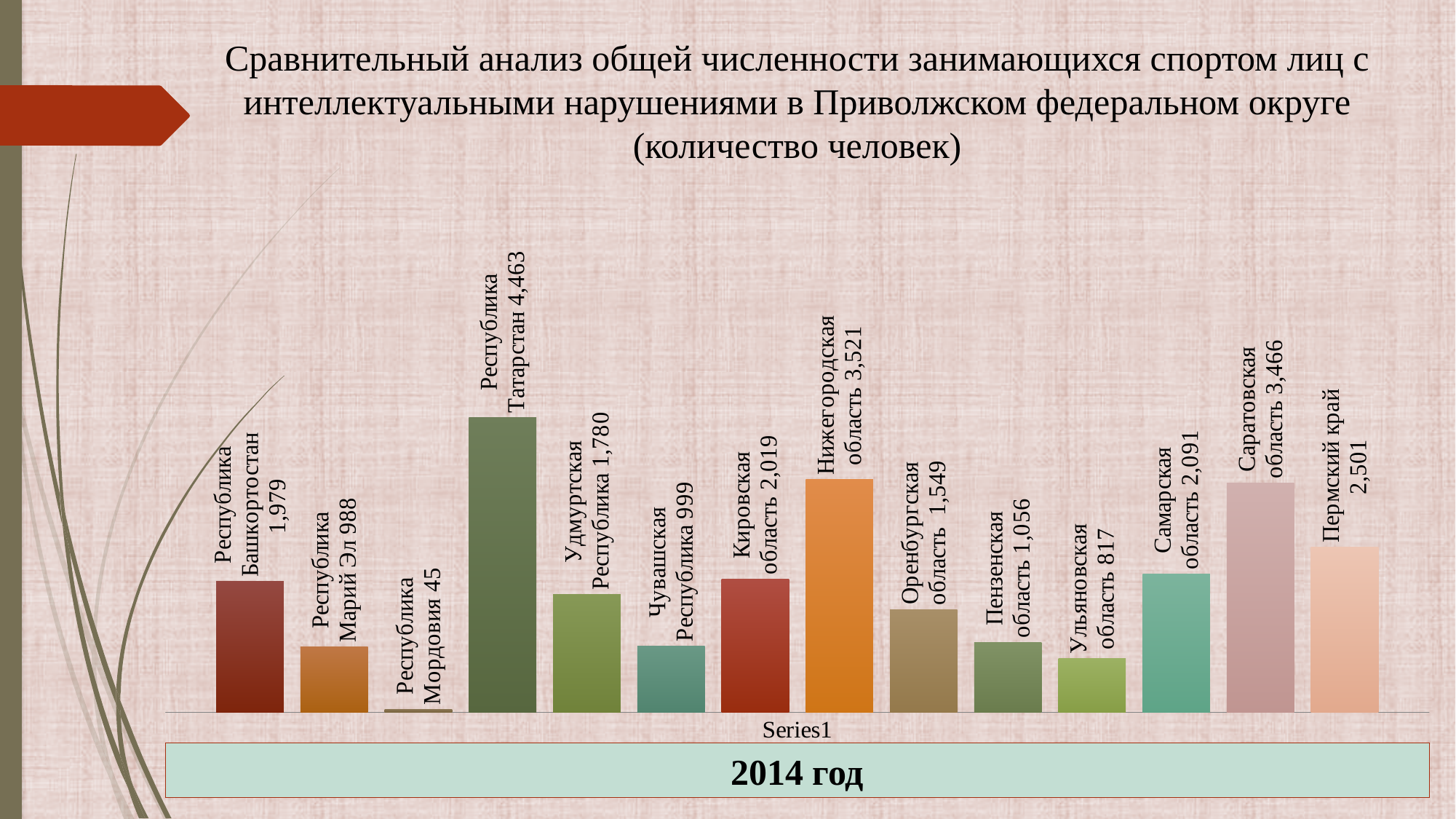
What is the value for Пермский край? 2,501 What is the difference between the values for Республика Татарстан and Саратовская область? 997 Which region has the lowest value? Республика Мордовия What kind of chart is shown on the slide? Bar chart Which region has the highest value? Республика Татарстан What is the value for Ульяновская область? 817 Which is larger, the value for Самарская область or the value for Удмуртская Республика? Самарская область What is the value for Нижегородская область? 3,521 What is the value for Республика Татарстан? 4,463 How many regions are shown in the chart? 14 Which year does the chart refer to, according to the label below the chart? 2014 год What is the difference between the values for Кировская область and Республика Башкортостан? 40